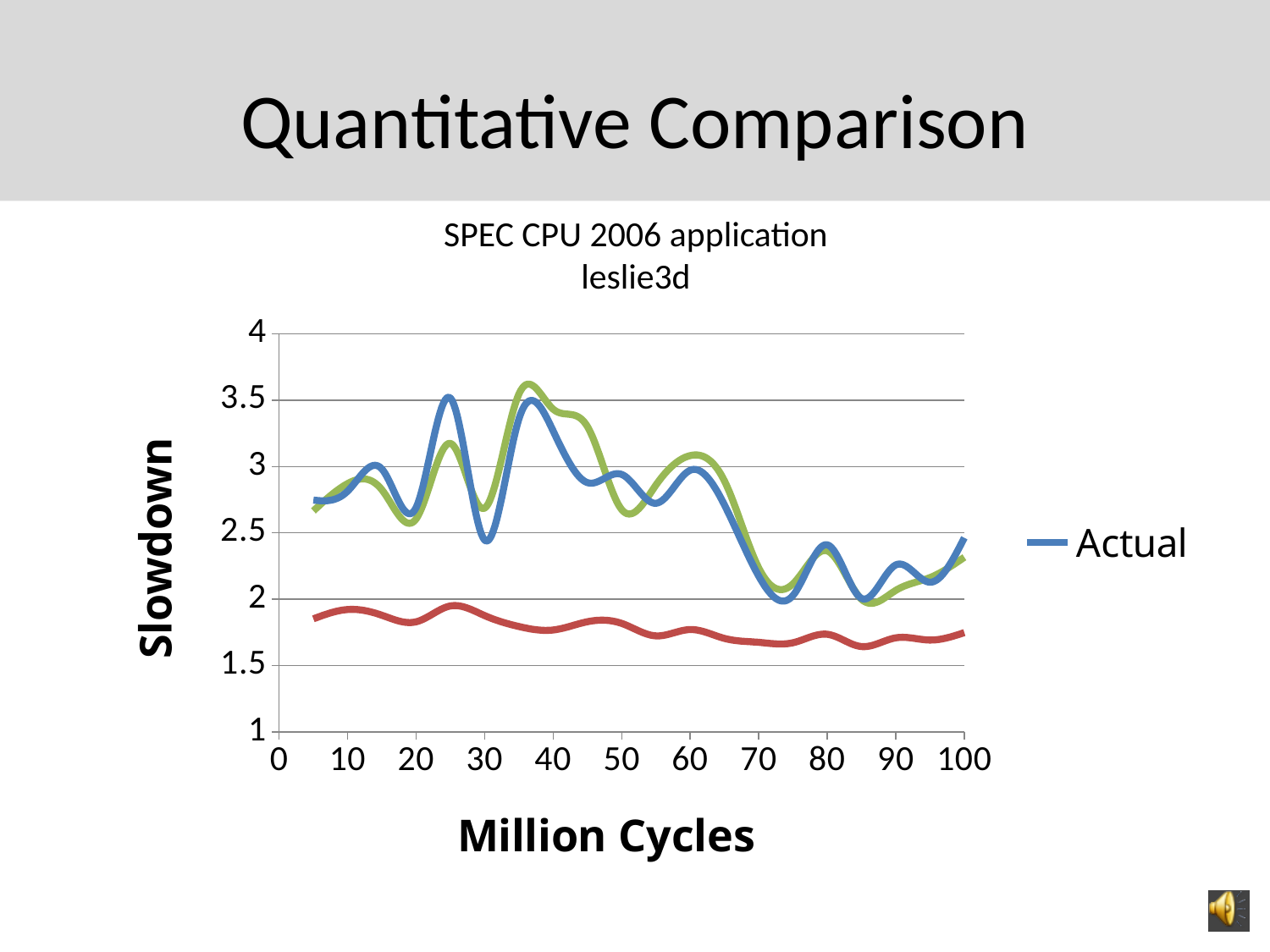
Is the Actual value at 40 million cycles larger or smaller than the Actual value at 80 million cycles? larger Is the value of the Actual series at 30 million cycles greater or less than 3? less Is the value of the Actual series at 10 million cycles greater or less than 2.5? greater Between 60 and 75 million cycles, does the Actual line rise or fall? fall Is the value of the Actual series at 40 million cycles greater or less than 3? greater What is the highest value marked on the y axis? 4 What kind of chart is shown on the slide? line chart How many series does the legend list? 1 What is the label of the y axis? Slowdown What is the title of the chart? SPEC CPU 2006 application leslie3d